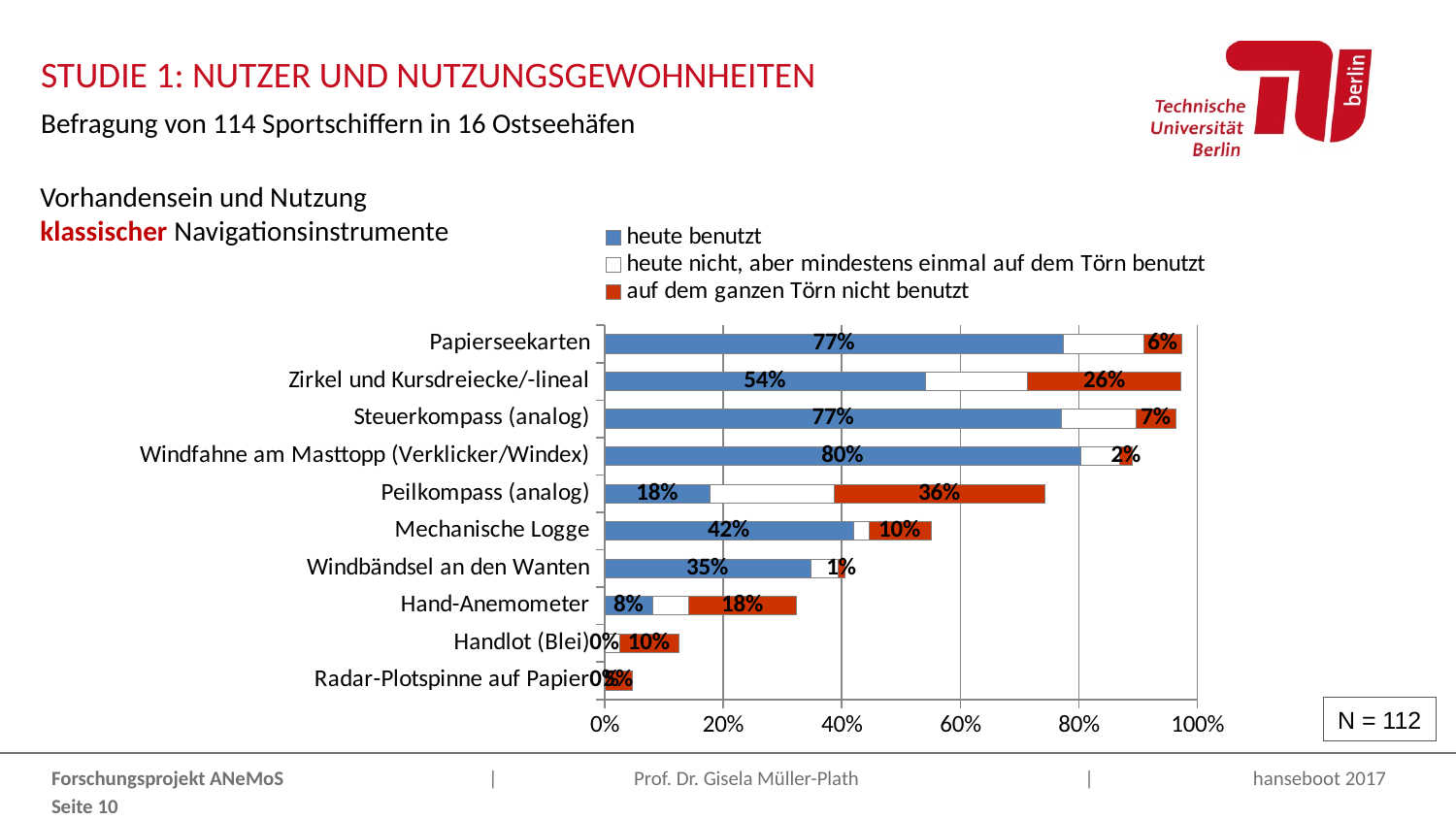
What is the difference between the "auf dem ganzen Törn nicht benutzt" values for Zirkel und Kursdreiecke/-lineal and Papierseekarten? 20 percentage points Which instrument has the highest "heute benutzt" value? Windfahne am Masttopp (Verklicker/Windex) What percentage of respondents use Papierseekarten today ("heute benutzt")? 77% How many navigation instruments are listed on the chart? 10 What kind of chart is shown on the slide? Stacked bar chart Is the total bar length for Peilkompass (analog) greater or less than 60%? greater What is the "auf dem ganzen Törn nicht benutzt" value for Hand-Anemometer? 18% Which has a larger "heute benutzt" value: Zirkel und Kursdreiecke/-lineal or Mechanische Logge? Zirkel und Kursdreiecke/-lineal What is the "heute benutzt" value for Mechanische Logge? 42% What is the "auf dem ganzen Törn nicht benutzt" value for Zirkel und Kursdreiecke/-lineal? 26% How many series does the legend list? 3 Which instrument has the highest "auf dem ganzen Törn nicht benutzt" value? Peilkompass (analog)